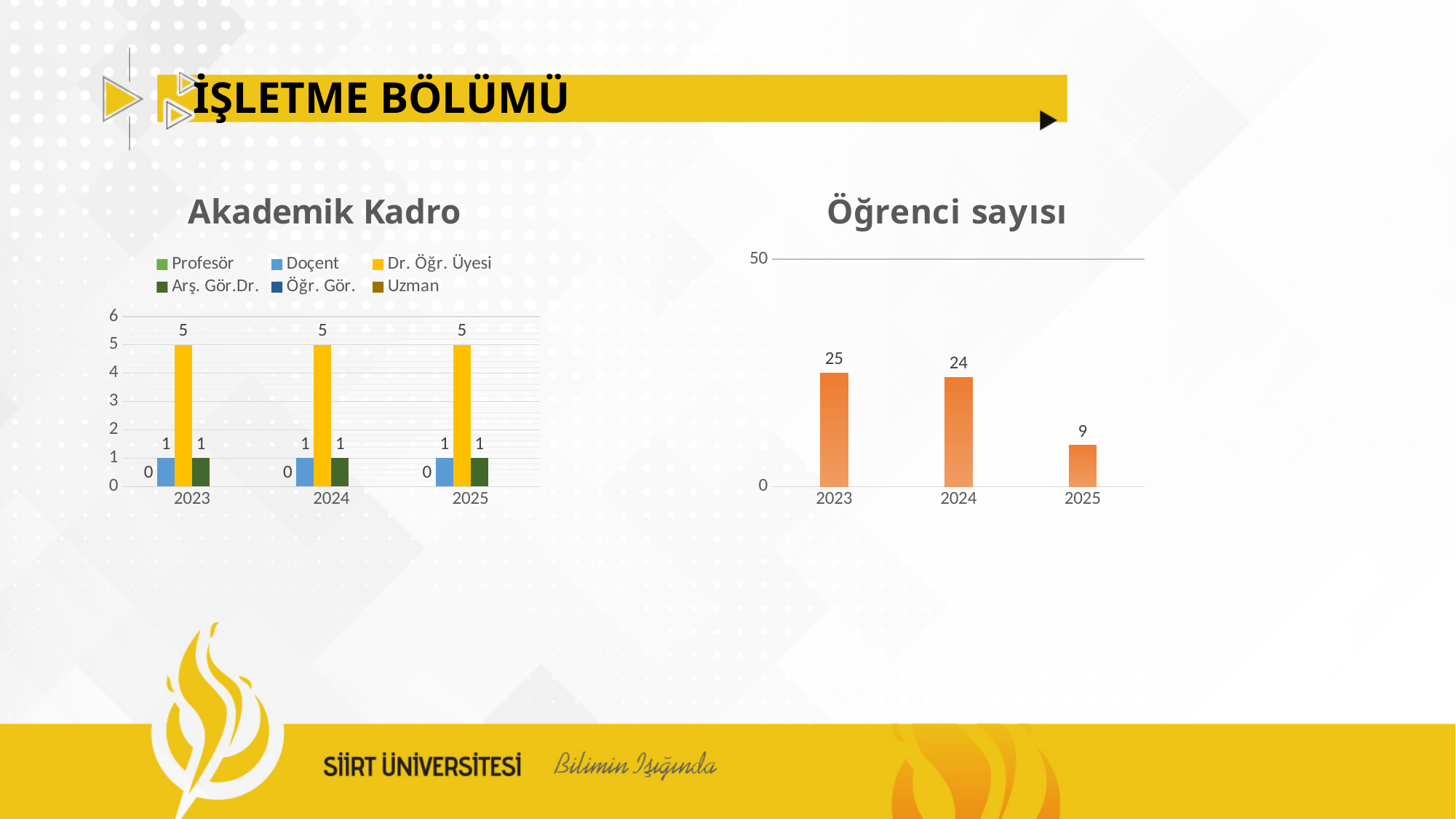
In the 'Akademik Kadro' chart, which is larger in 2025: Dr. Öğr. Üyesi or Arş. Gör.Dr.? Dr. Öğr. Üyesi In the 'Öğrenci sayısı' chart, which year has the lowest value? 2025 How many series does the legend of the 'Akademik Kadro' chart list? 6 In the 'Öğrenci sayısı' chart, do the values rise or fall from 2023 to 2025? fall How many years are shown on the x axis of the 'Öğrenci sayısı' chart? 3 In the 'Akademik Kadro' chart, what is the value for Dr. Öğr. Üyesi in 2024? 5 In the 'Öğrenci sayısı' chart, what is the value for 2025? 9 In the 'Öğrenci sayısı' chart, which year has the highest value? 2023 In the 'Akademik Kadro' chart, what is the value for Doçent in 2023? 1 In the 'Öğrenci sayısı' chart, what is the difference between the values for 2024 and 2025? 15 What kind of chart is the 'Akademik Kadro' chart? bar chart In the 'Öğrenci sayısı' chart, what is the value for 2023? 25